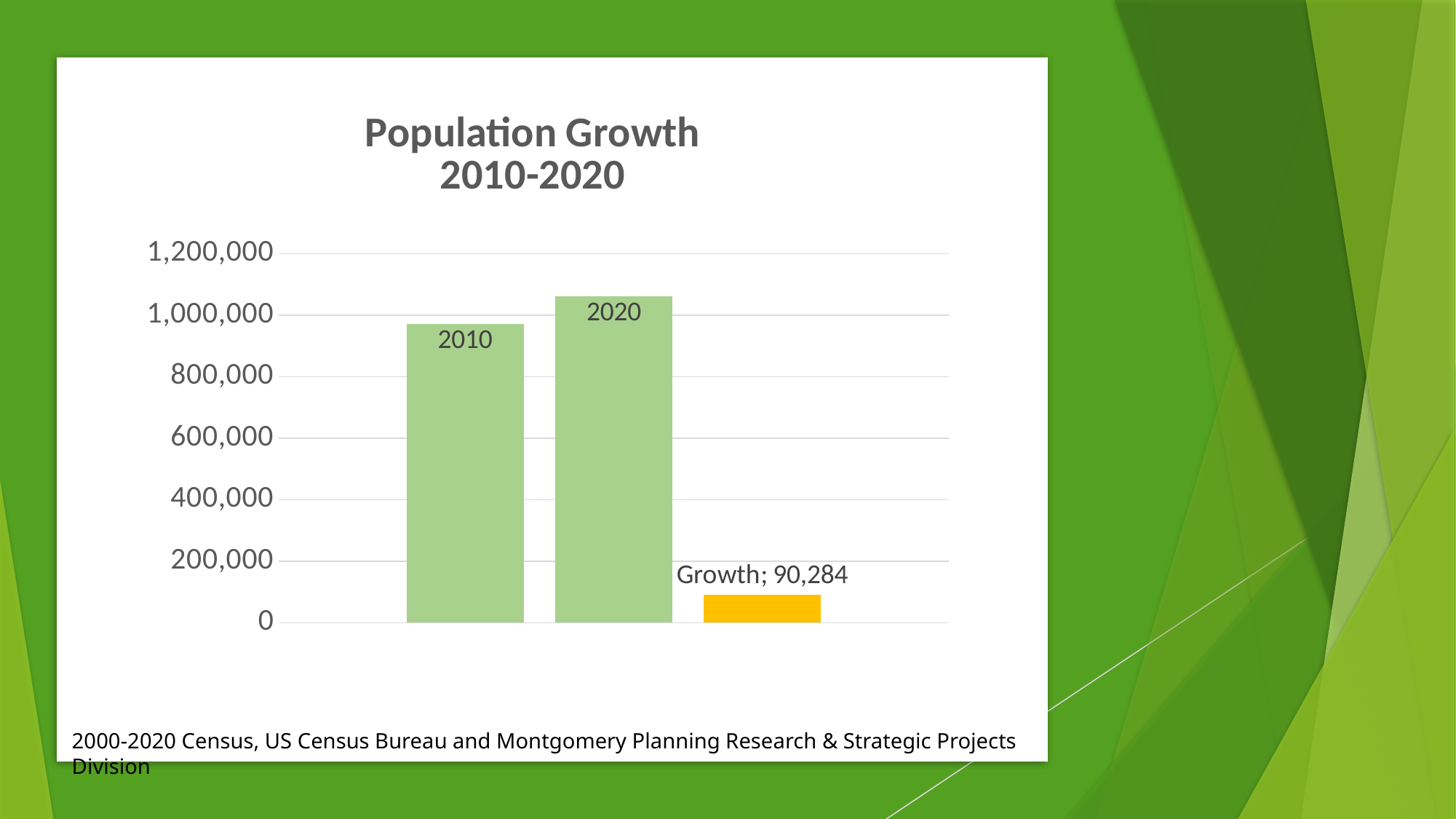
How many bars are plotted in the chart? 3 What kind of chart is shown on the slide? bar chart Which bar is the tallest in the chart? 2020 Which is larger, the value for 2010 or the value for 2020? 2020 Is the value for 2010 greater or less than 1,000,000? less Is the value for Growth greater or less than 200,000? less What is the title of the chart? Population Growth 2010-2020 What value is shown for Growth? 90,284 Which bar is the shortest in the chart? Growth Does the population rise or fall from 2010 to 2020? rise What colour is the Growth bar? yellow Is the value for 2020 greater or less than 1,000,000? greater